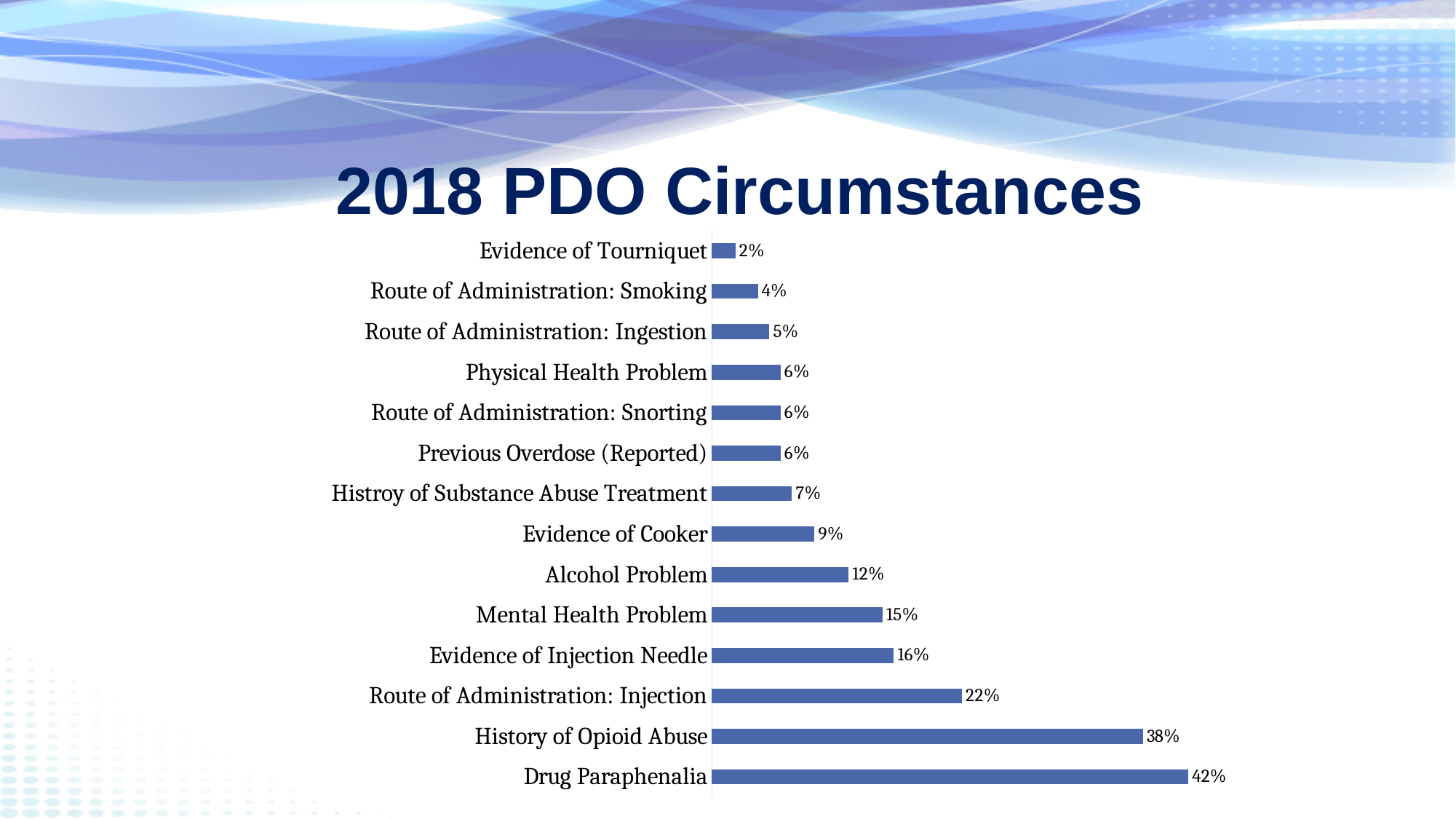
What is the difference between Drug Paraphenalia and History of Opioid Abuse? 4% What is the value for History of Opioid Abuse? 38% Which is larger, Alcohol Problem or Evidence of Cooker? Alcohol Problem Which category has the highest value? Drug Paraphenalia What is the value for Mental Health Problem? 15% What kind of chart is shown on the slide? Bar chart How many categories are shown in the chart? 14 What is the value for Evidence of Cooker? 9% What is the title of the slide? 2018 PDO Circumstances Which category has the lowest value? Evidence of Tourniquet What is the difference between Route of Administration: Injection and Evidence of Injection Needle? 6% What is the value for Drug Paraphenalia? 42%